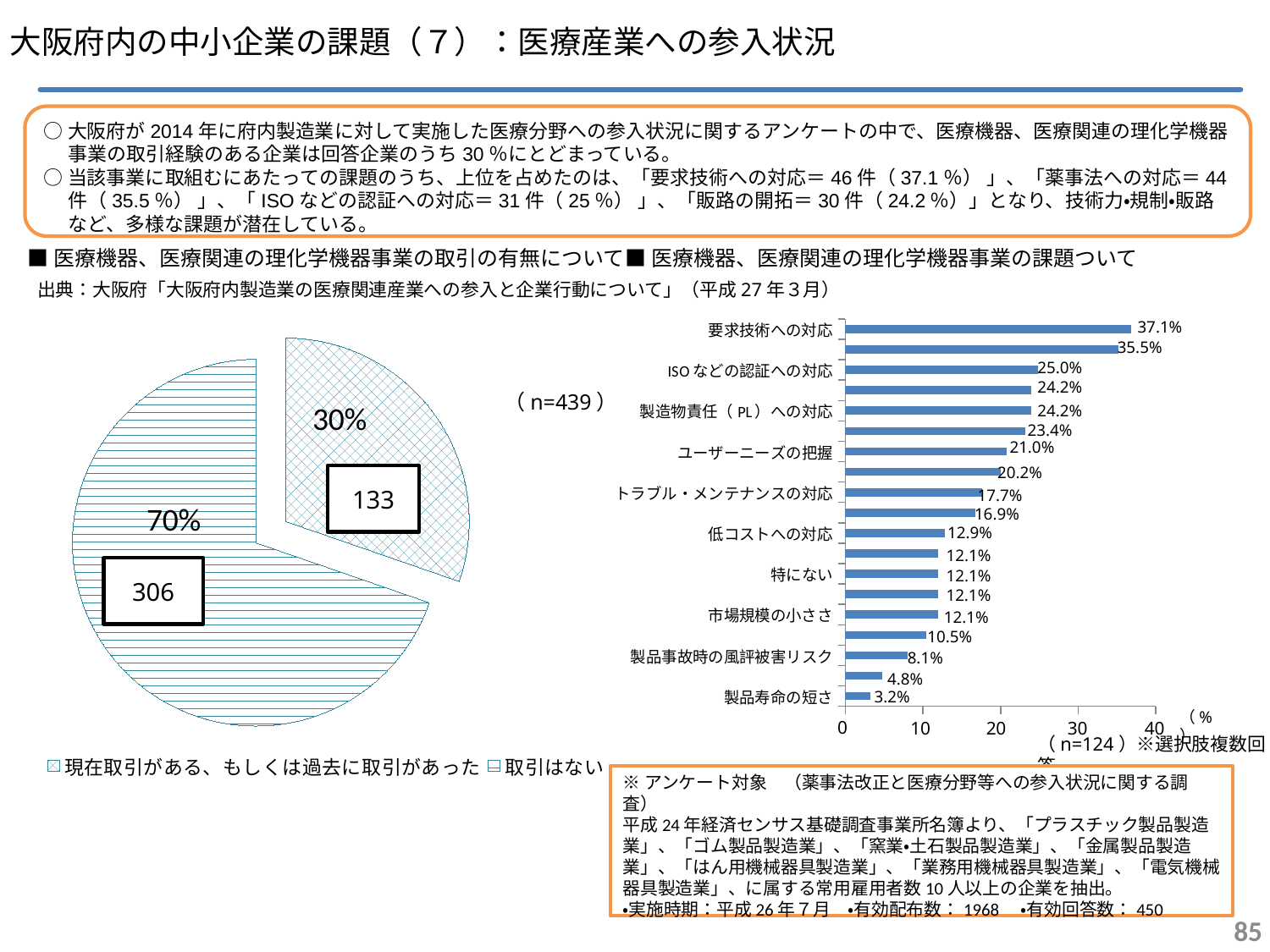
How many entries does the legend of the pie chart on the left list? 2 In the pie chart on the left, what count is shown for the 70% slice? 306 In the bar chart on the right, which labeled category has the lowest value? 製品寿命の短さ In the bar chart on the right, what is the difference between the values for 要求技術への対応 and 製品寿命の短さ? 33.9% In the pie chart on the left, what count is shown for the 30% slice (現在取引がある、もしくは過去に取引があった)? 133 In the bar chart on the right, which labeled category has the highest value? 要求技術への対応 In the pie chart on the left, what share is shown for 取引はない? 70% What kind of chart is the chart on the right of the slide? bar chart In the bar chart on the right, what is the value for 要求技術への対応? 37.1% In the bar chart on the right, which is larger: the value for ISOなどの認証への対応 or the value for ユーザーニーズの把握? ISOなどの認証への対応 In the bar chart on the right, what is the value for ISOなどの認証への対応? 25.0% What kind of chart is the chart on the left of the slide? pie chart